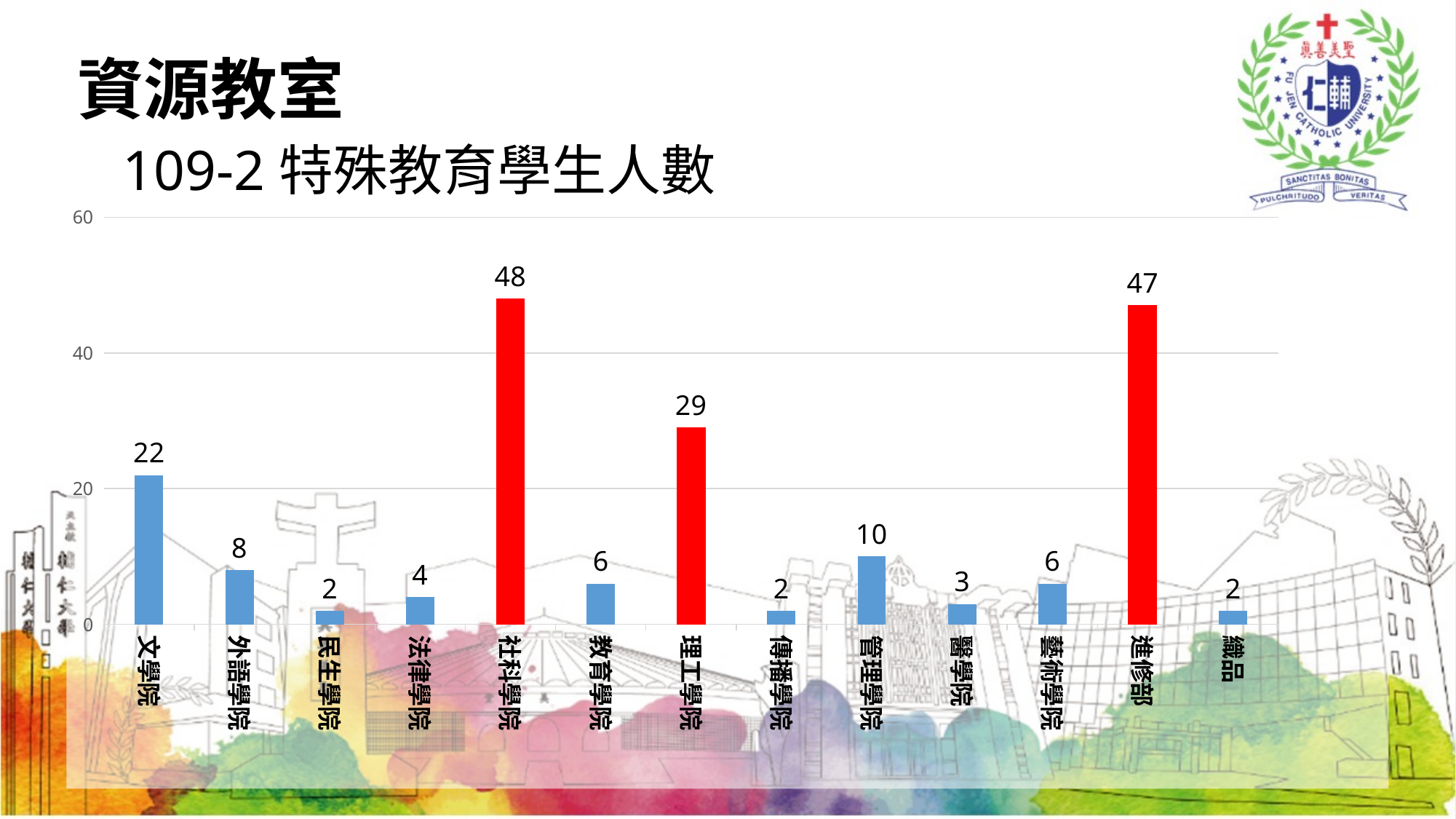
What is the value for 管理學院? 10 What is the value for 進修部? 47 What is the difference between the values for 文學院 and 外語學院? 14 What is the value for 社科學院? 48 Which is larger, the value for 文學院 or the value for 理工學院? 理工學院 Which category has the highest value? 社科學院 Is the value for 進修部 greater or less than 40? greater What is the difference between the values for 社科學院 and 進修部? 1 What kind of chart is shown on the slide? bar chart Which three categories have red bars? 社科學院, 理工學院, 進修部 What is the value for 理工學院? 29 How many categories are shown on the x axis? 13